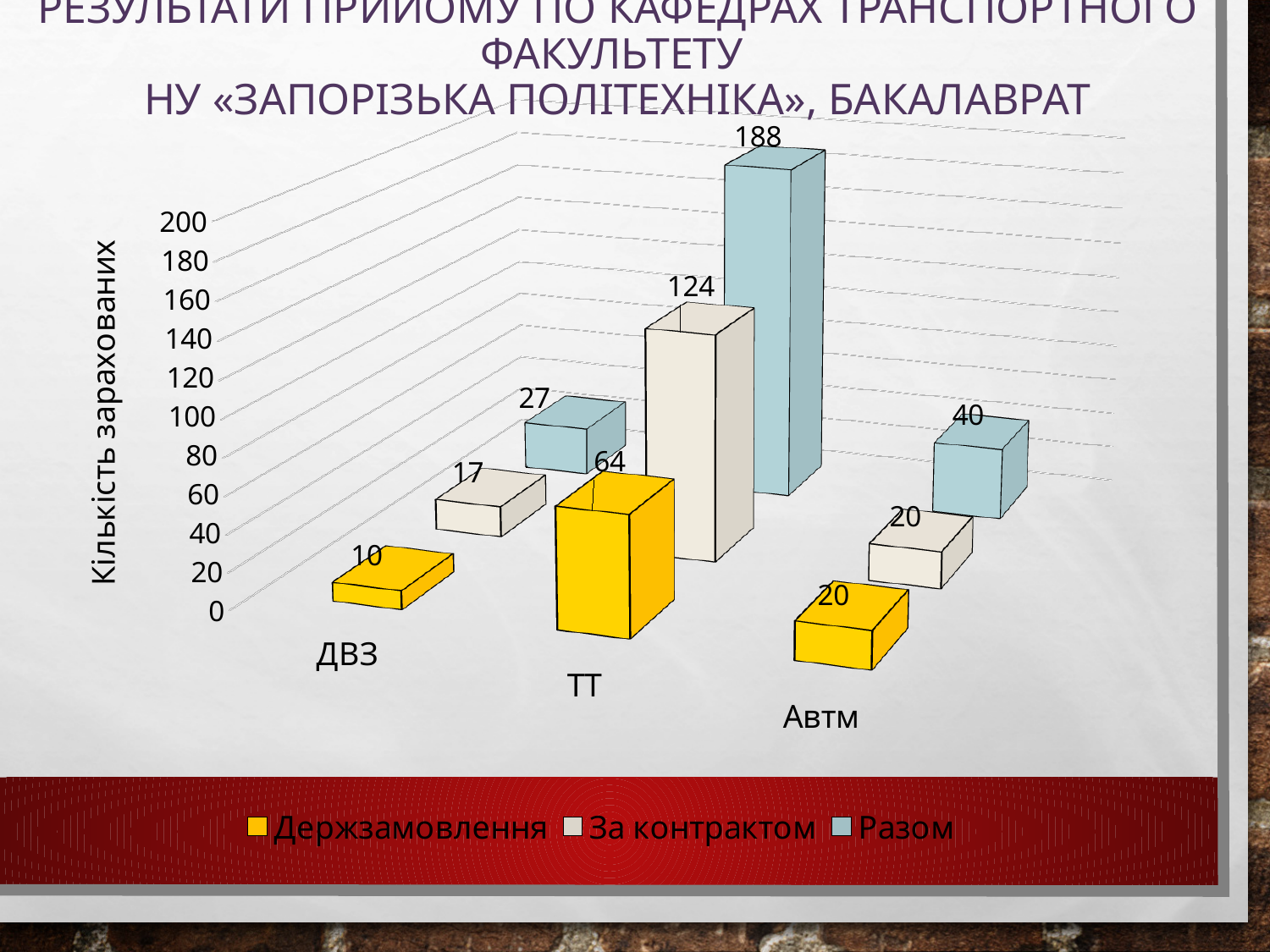
What is the value of Разом for ТТ? 188 What is the label of the vertical axis? Кількість зарахованих What kind of chart is shown on the slide? Bar chart What is the value of За контрактом for ТТ? 124 How many series does the legend list? 3 Which category has the highest Разом value? ТТ How many categories are shown on the x axis? 3 What is the difference between the Разом values for ТТ and Автм? 148 Which is larger: За контрактом for ДВЗ or За контрактом for Автм? За контрактом for Автм Which category has the lowest Держзамовлення value? ДВЗ What is the value of Держзамовлення for ДВЗ? 10 What is the value of За контрактом for Автм? 20